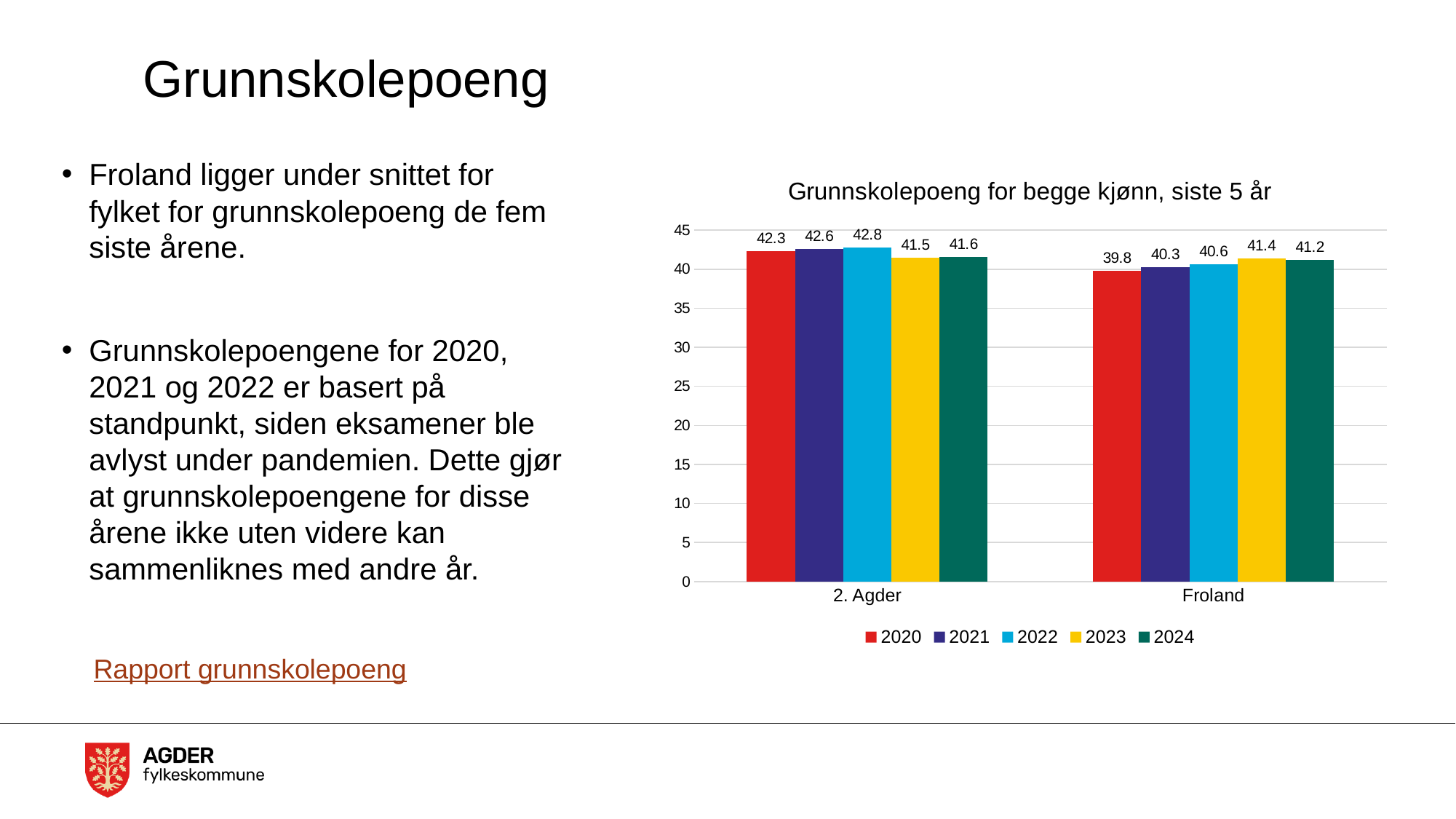
Which is larger, the 2023 value for 2. Agder or the 2023 value for Froland? 2. Agder How many series does the legend list? 5 What is the value for Froland in 2020? 39.8 How many categories are shown on the x axis? 2 Which year has the highest value for 2. Agder? 2022 What kind of chart is shown on the slide? Bar chart What is the title of the chart? Grunnskolepoeng for begge kjønn, siste 5 år What is the value for 2. Agder in 2022? 42.8 What is the value for Froland in 2024? 41.2 What is the difference between the 2. Agder and Froland values in 2020? 2.5 Which year has the lowest value for Froland? 2020 What is the value for 2. Agder in 2023? 41.5